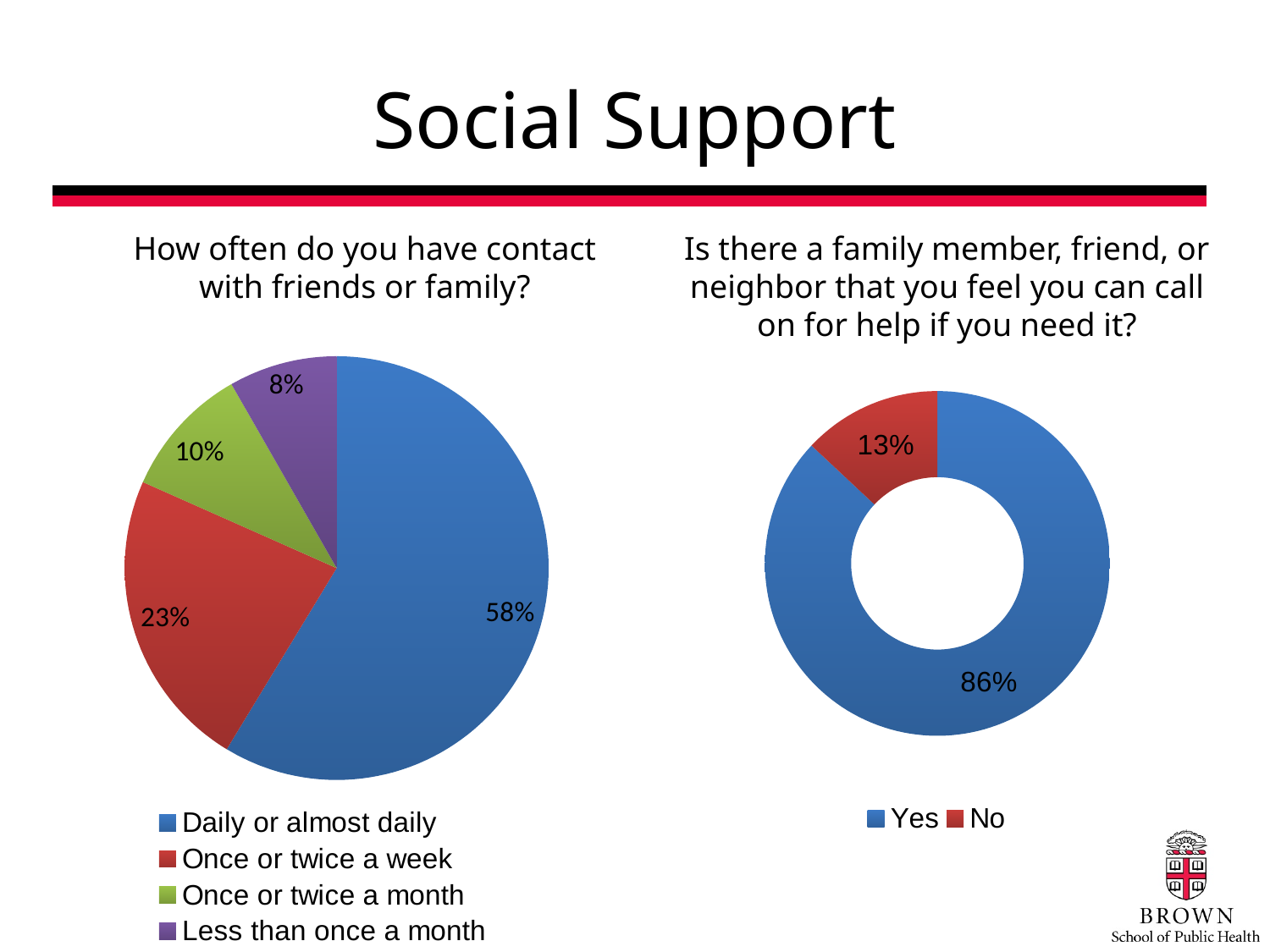
What kind of chart is the one on the left, titled 'How often do you have contact with friends or family?'? Pie chart In the chart titled 'How often do you have contact with friends or family?', what percentage is shown for 'Less than once a month'? 8% In the chart on the right, titled 'Is there a family member, friend, or neighbor that you feel you can call on for help if you need it?', what percentage answered 'Yes'? 86% In the chart titled 'How often do you have contact with friends or family?', how many categories does the legend list? 4 In the chart on the right, titled 'Is there a family member, friend, or neighbor that you feel you can call on for help if you need it?', what colour represents 'No'? Red In the chart titled 'How often do you have contact with friends or family?', what percentage is shown for 'Daily or almost daily'? 58% In the chart titled 'How often do you have contact with friends or family?', what is the difference in percentage points between 'Once or twice a week' and 'Once or twice a month'? 13 In the chart on the right, titled 'Is there a family member, friend, or neighbor that you feel you can call on for help if you need it?', what percentage answered 'No'? 13% In the chart titled 'How often do you have contact with friends or family?', which category has the largest share? Daily or almost daily In the chart on the right, titled 'Is there a family member, friend, or neighbor that you feel you can call on for help if you need it?', which is larger, 'Yes' or 'No'? Yes In the chart titled 'How often do you have contact with friends or family?', which category has the smallest share? Less than once a month In the chart titled 'How often do you have contact with friends or family?', what percentage is shown for 'Once or twice a week'? 23%